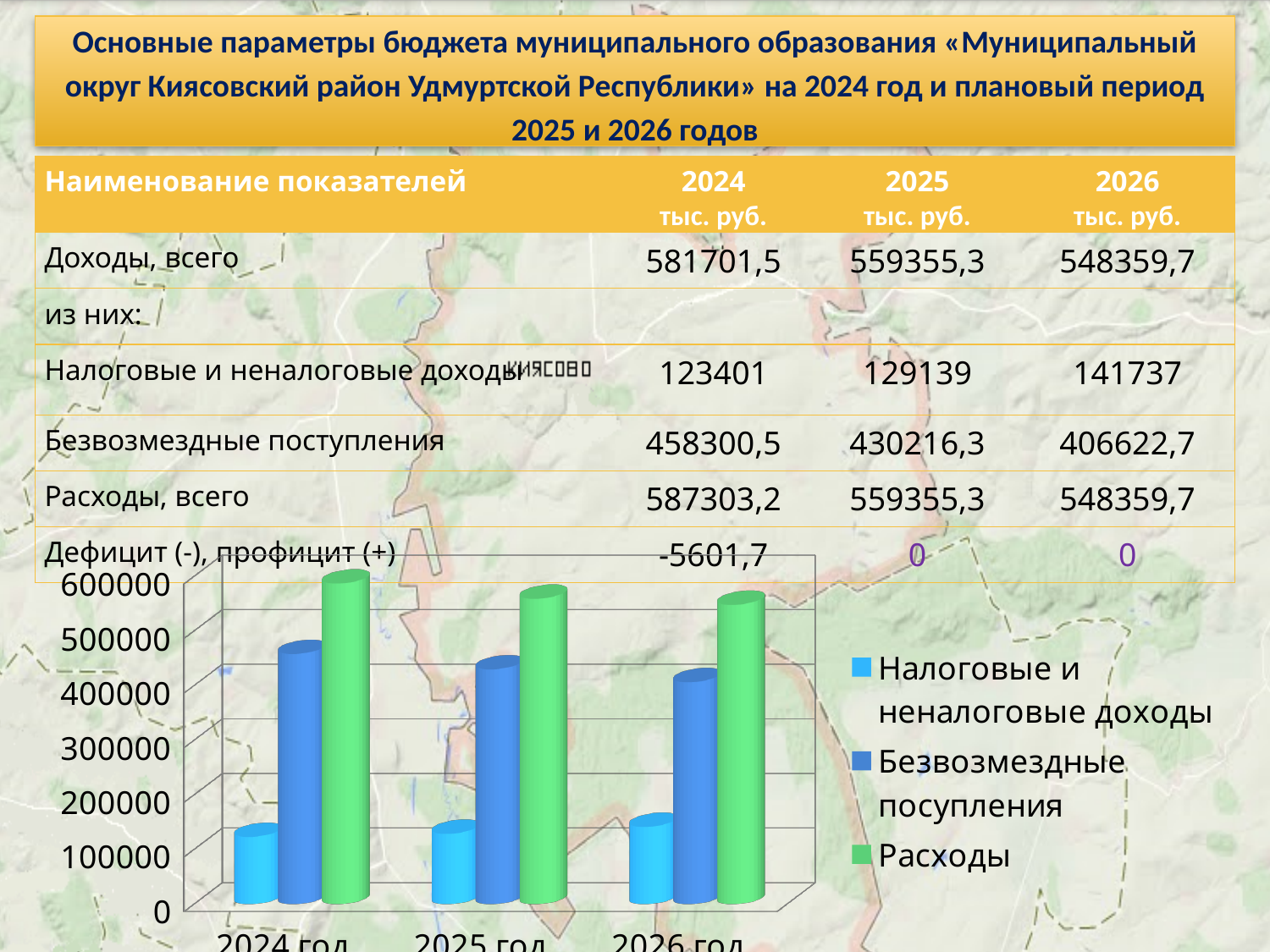
Which bar is the tallest in the chart? Расходы, 2024 год Is the value for Безвозмездные посупления in 2024 год greater or less than 400000? greater What kind of chart is shown at the bottom of the slide? bar chart Is the value for Безвозмездные посупления in 2025 год greater or less than 500000? less How many series does the chart legend list? 3 Is the value for Налоговые и неналоговые доходы in 2024 год greater or less than 200000? less Do the values for Расходы rise or fall from 2024 год to 2026 год? fall In 2024 год, which is larger: Расходы or Безвозмездные посупления? Расходы Which series is shown in green in the chart? Расходы Do the values for Налоговые и неналоговые доходы rise or fall from 2024 год to 2026 год? rise How many year categories are shown on the chart's x axis? 3